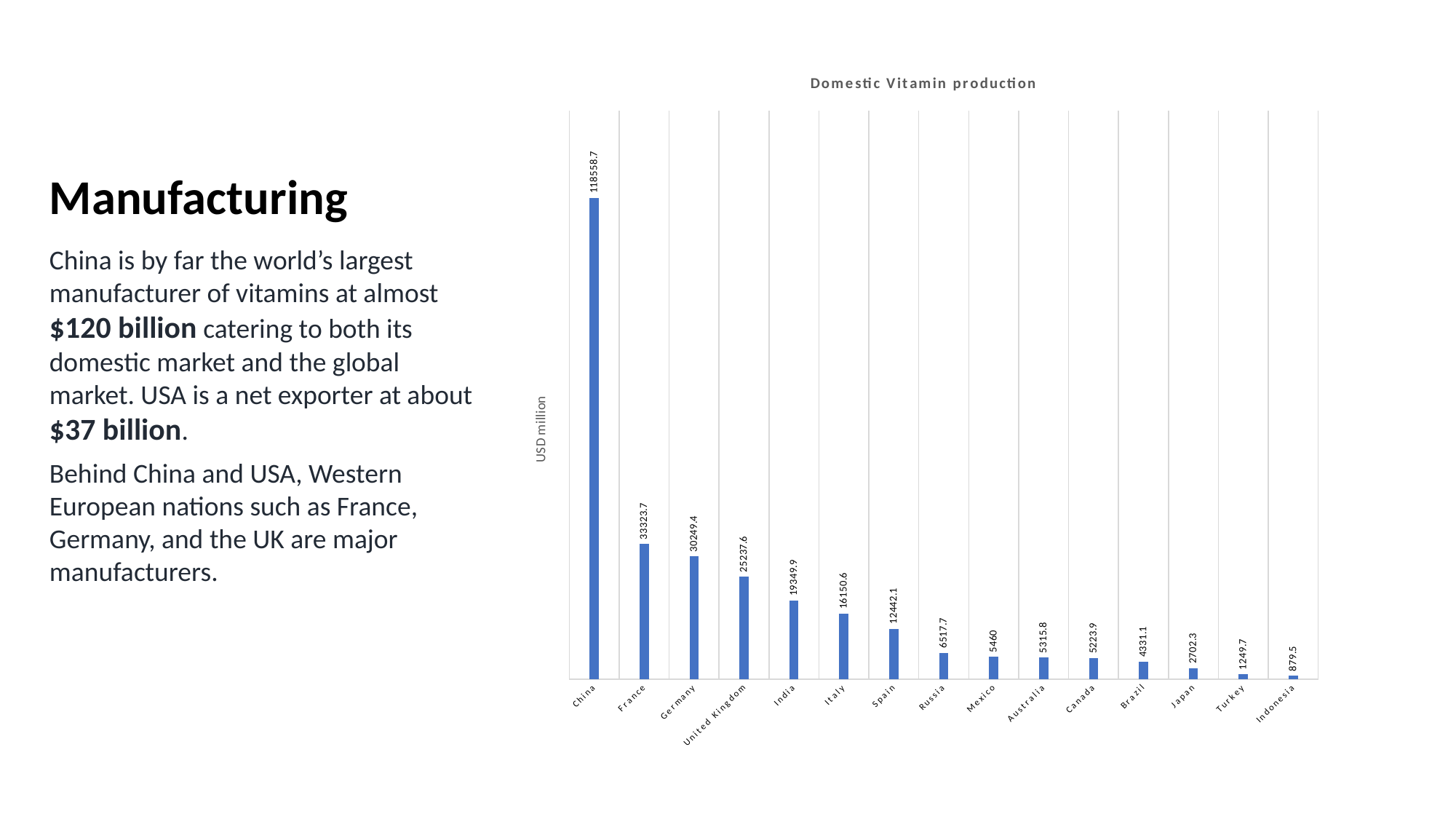
Which country has the lowest value in the Domestic Vitamin production chart? Indonesia What is the difference between the values for France and Germany in the Domestic Vitamin production chart? 3074.3 What is the value for Germany in the Domestic Vitamin production chart? 30249.4 How many countries are shown in the Domestic Vitamin production chart? 15 What is the label on the vertical axis of the Domestic Vitamin production chart? USD million Which has a larger value in the Domestic Vitamin production chart, Spain or Russia? Spain What kind of chart is the Domestic Vitamin production chart? Bar chart Which country has the highest value in the Domestic Vitamin production chart? China What is the value for Mexico in the Domestic Vitamin production chart? 5460 What is the value for China in the Domestic Vitamin production chart? 118558.7 What is the difference between the values for India and Italy in the Domestic Vitamin production chart? 3199.3 What is the value for Indonesia in the Domestic Vitamin production chart? 879.5